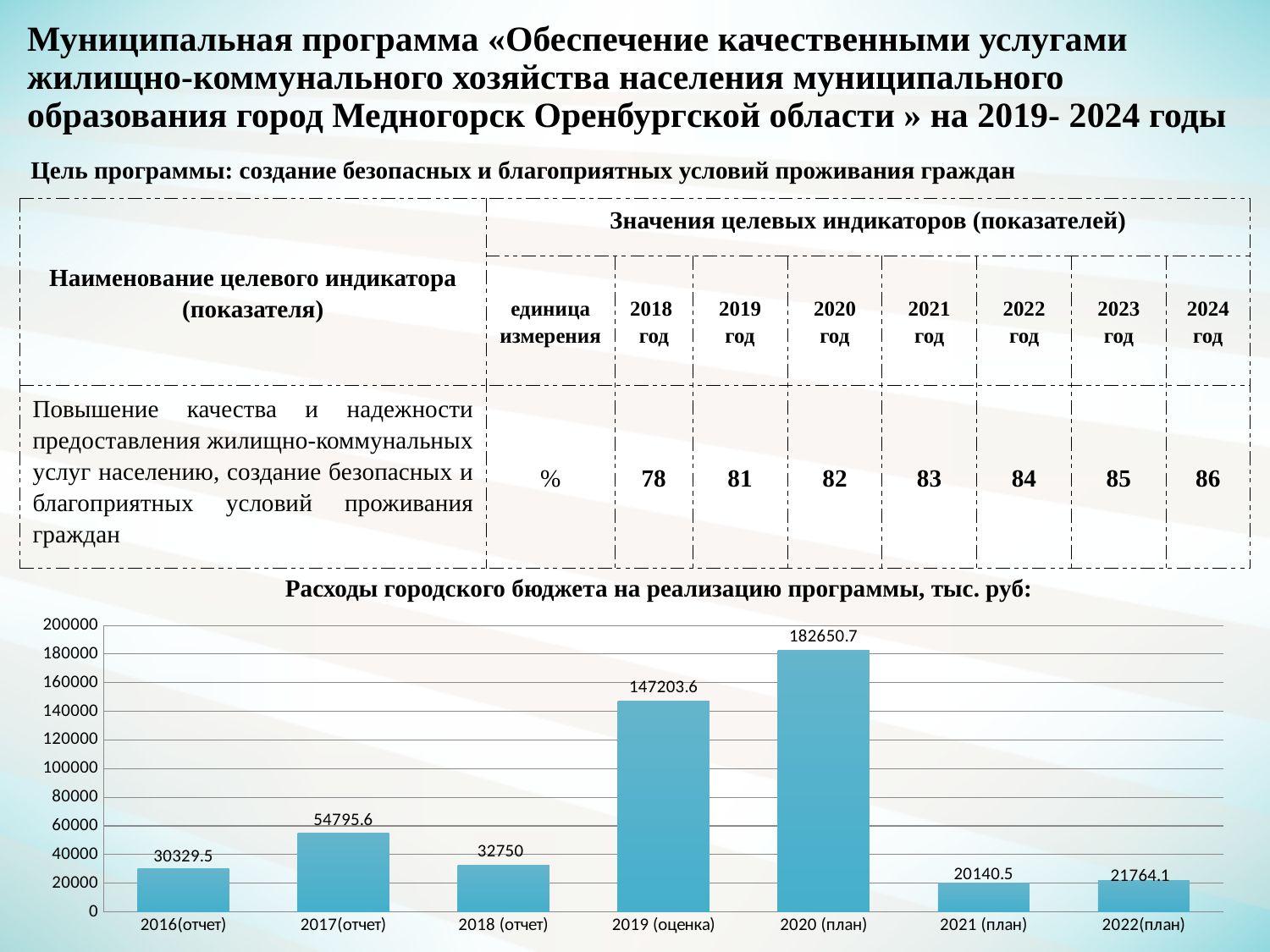
What is the value for 2016(отчет) in the chart? 30329.5 What kind of chart is shown on the slide? bar chart What is the value for 2019 (оценка) in the chart? 147203.6 How many categories are shown on the x axis of the chart? 7 Which category has the highest value in the chart? 2020 (план) Which category has the lowest value in the chart? 2021 (план) What is the difference between the values for 2020 (план) and 2019 (оценка)? 35447.1 What is the value for 2021 (план) in the chart? 20140.5 What is the title of the chart? Расходы городского бюджета на реализацию программы, тыс. руб: Is the value for 2020 (план) greater or less than 160000? greater Which is larger, the value for 2017(отчет) or the value for 2018 (отчет)? 2017(отчет) What is the difference between the values for 2017(отчет) and 2018 (отчет)? 22045.6